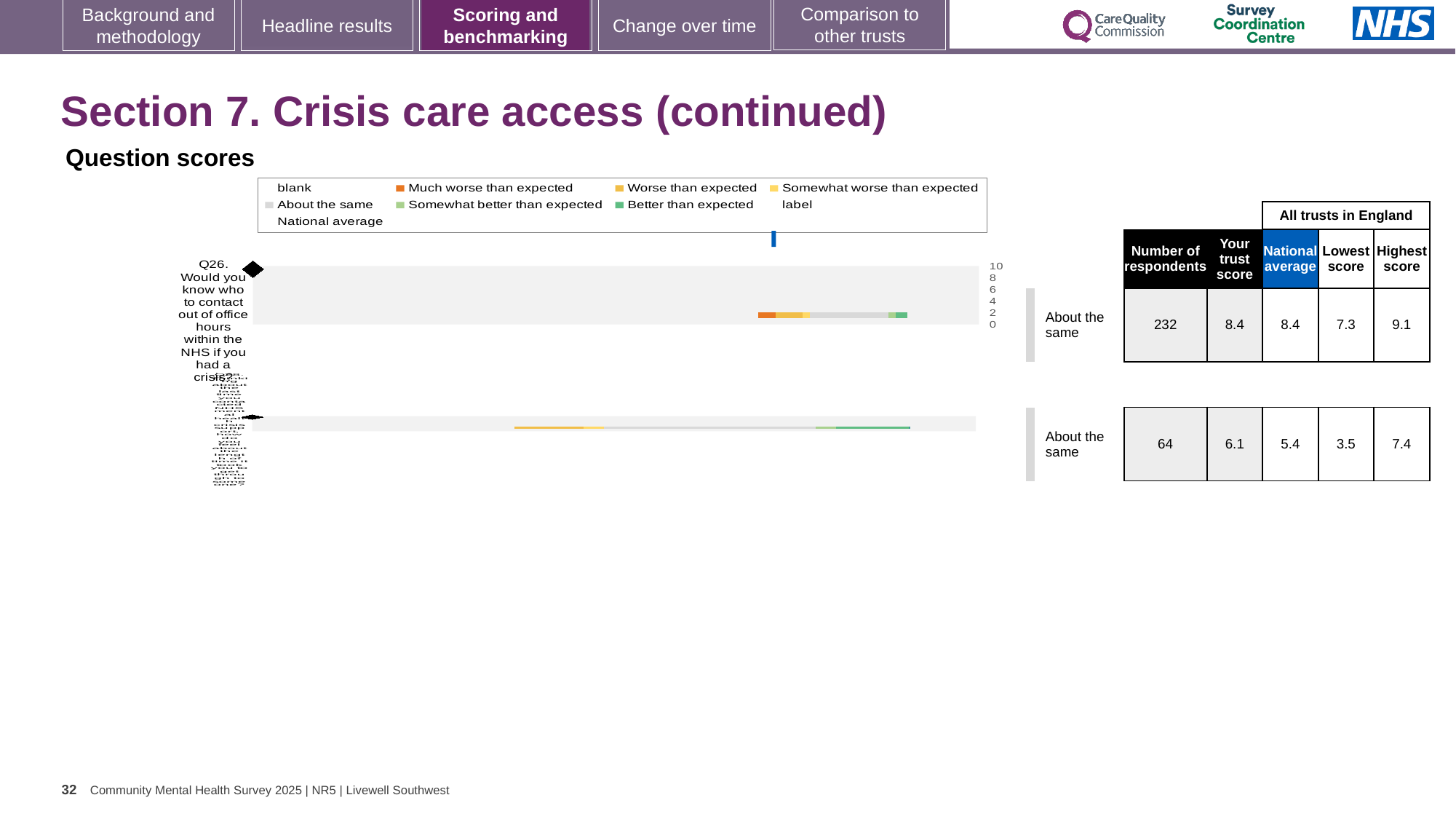
What is the highest value shown on the chart's numeric axis? 10 What kind of chart is shown under 'Question scores'? bar chart For the second question row on the chart, which is larger: your trust score or the national average? your trust score For the second question row on the chart, what is the number of respondents? 64 For Q26, what is the highest score among all trusts in England? 9.1 For Q26, what is your trust score? 8.4 For Q26 (Would you know who to contact out of office hours within the NHS if you had a crisis?), what is the number of respondents? 232 For Q26, what is the difference between the highest score and the lowest score among all trusts in England? 1.8 Which colour does the legend use for 'Much worse than expected'? orange For the second question row on the chart, what is the difference between your trust score and the national average? 0.7 For Q26, what benchmark category is the trust placed in? About the same For Q26, what is the national average? 8.4